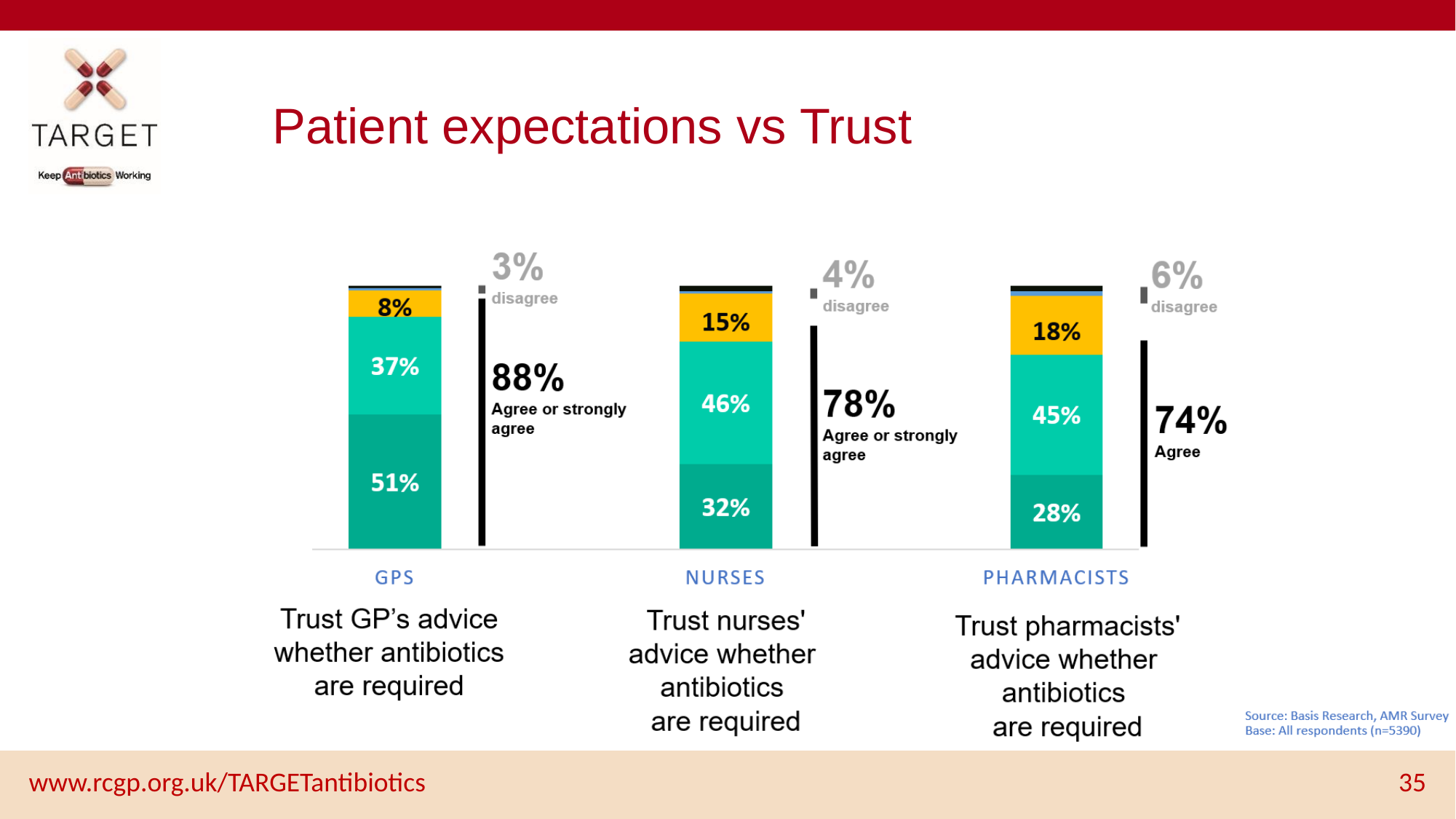
What type of chart is used on this slide? Stacked bar chart Which group has the lowest percentage of respondents who disagree that they trust its advice on whether antibiotics are required? GPs Which is larger: the bottom segment of the Nurses bar or the bottom segment of the Pharmacists bar? Nurses (32%) What is the value of the top (yellow) segment of the Nurses bar? 15% What is the value of the bottom (dark teal) segment of the GPs bar? 51% What is the difference between the agree percentage for GPs (88%) and for pharmacists (74%)? 14% What percentage of respondents agree or strongly agree that they trust nurses' advice whether antibiotics are required? 78% How many groups (categories) are shown on the x axis of the chart? 3 What percentage of respondents agree or strongly agree that they trust GP's advice whether antibiotics are required? 88% What percentage of respondents disagree that they trust pharmacists' advice whether antibiotics are required? 6% Which group has the highest percentage of respondents who agree or strongly agree that they trust its advice on whether antibiotics are required? GPs What percentage of respondents agree that they trust pharmacists' advice whether antibiotics are required? 74%